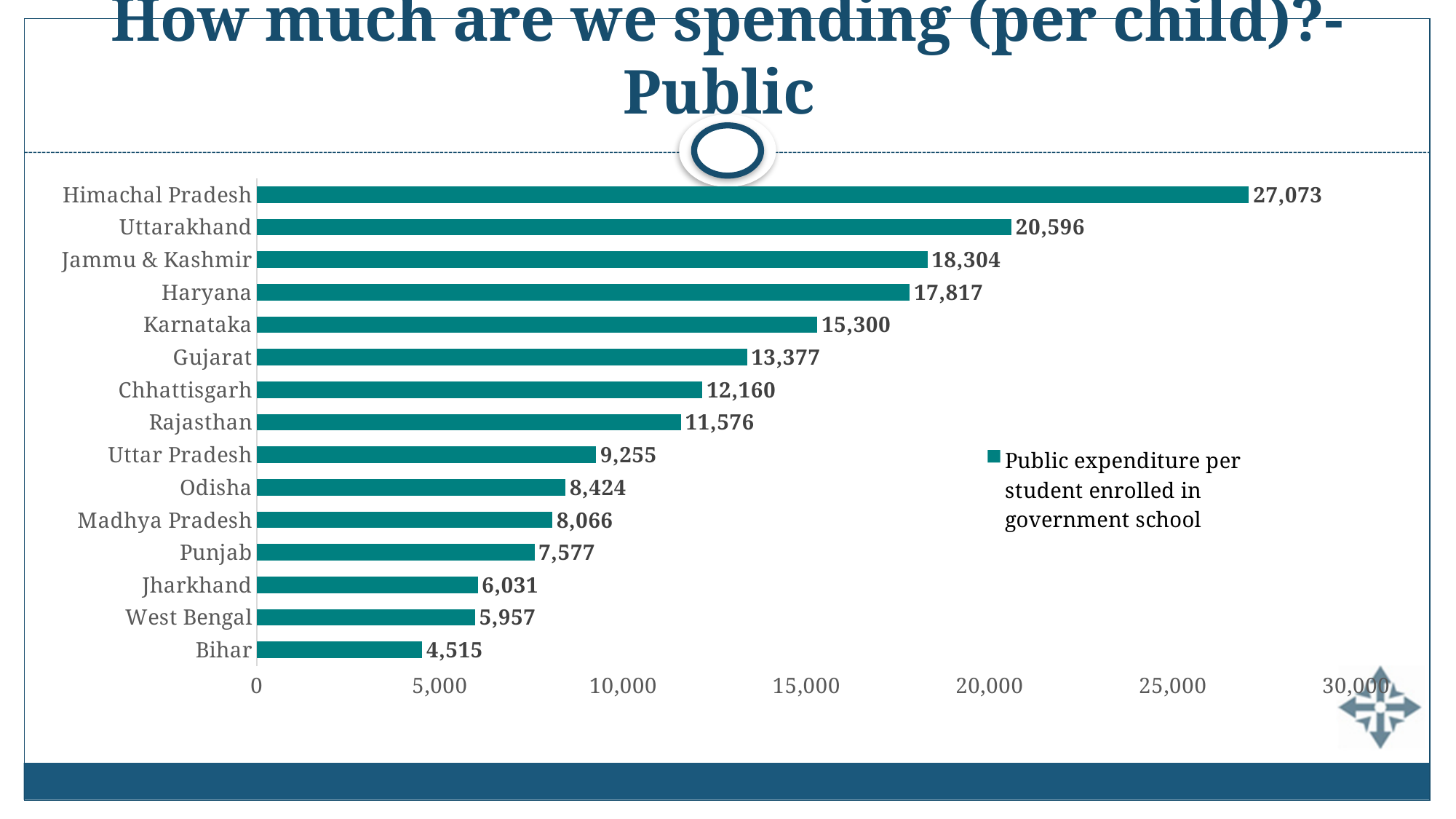
What is the difference between the values for Uttarakhand and Jammu & Kashmir? 2,292 Which has a larger value, Gujarat or Chhattisgarh? Gujarat What kind of chart is shown on the slide? Bar chart Is the value for Haryana greater or less than 15,000? greater How many series does the legend list? 1 What is the legend entry for the series in the chart? Public expenditure per student enrolled in government school What is the public expenditure per student enrolled in government school for Himachal Pradesh? 27,073 What is the value shown for Karnataka? 15,300 Which state has the lowest public expenditure per student? Bihar Which state has the highest public expenditure per student? Himachal Pradesh How many states are shown in the chart? 15 What is the value shown for Punjab? 7,577